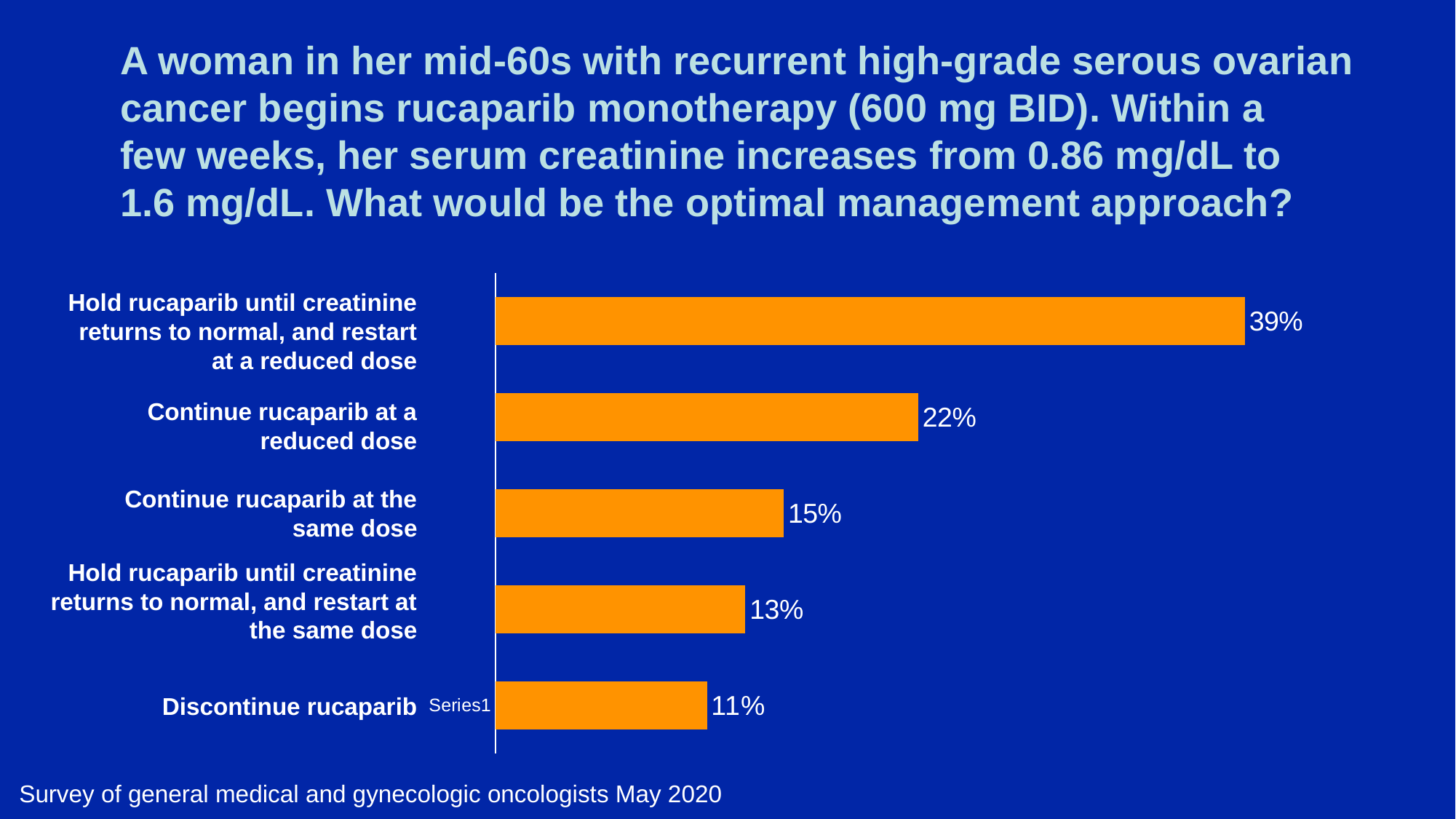
What kind of chart is shown on the slide? Bar chart What percentage of respondents chose "Continue rucaparib at the same dose"? 15% What percentage of respondents chose "Continue rucaparib at a reduced dose"? 22% What is the difference in percentage points between "Hold rucaparib until creatinine returns to normal, and restart at the same dose" and "Discontinue rucaparib"? 2 percentage points What is the difference in percentage points between "Hold rucaparib until creatinine returns to normal, and restart at a reduced dose" and "Continue rucaparib at a reduced dose"? 17 percentage points How many management approaches are shown in the chart? 5 What percentage of respondents chose "Hold rucaparib until creatinine returns to normal, and restart at a reduced dose"? 39% What colour are the bars in the chart? Orange What percentage of respondents chose "Discontinue rucaparib"? 11% Which management approach received the highest percentage of responses? Hold rucaparib until creatinine returns to normal, and restart at a reduced dose Which received a larger share of responses: "Continue rucaparib at the same dose" or "Hold rucaparib until creatinine returns to normal, and restart at the same dose"? Continue rucaparib at the same dose Which management approach received the lowest percentage of responses? Discontinue rucaparib